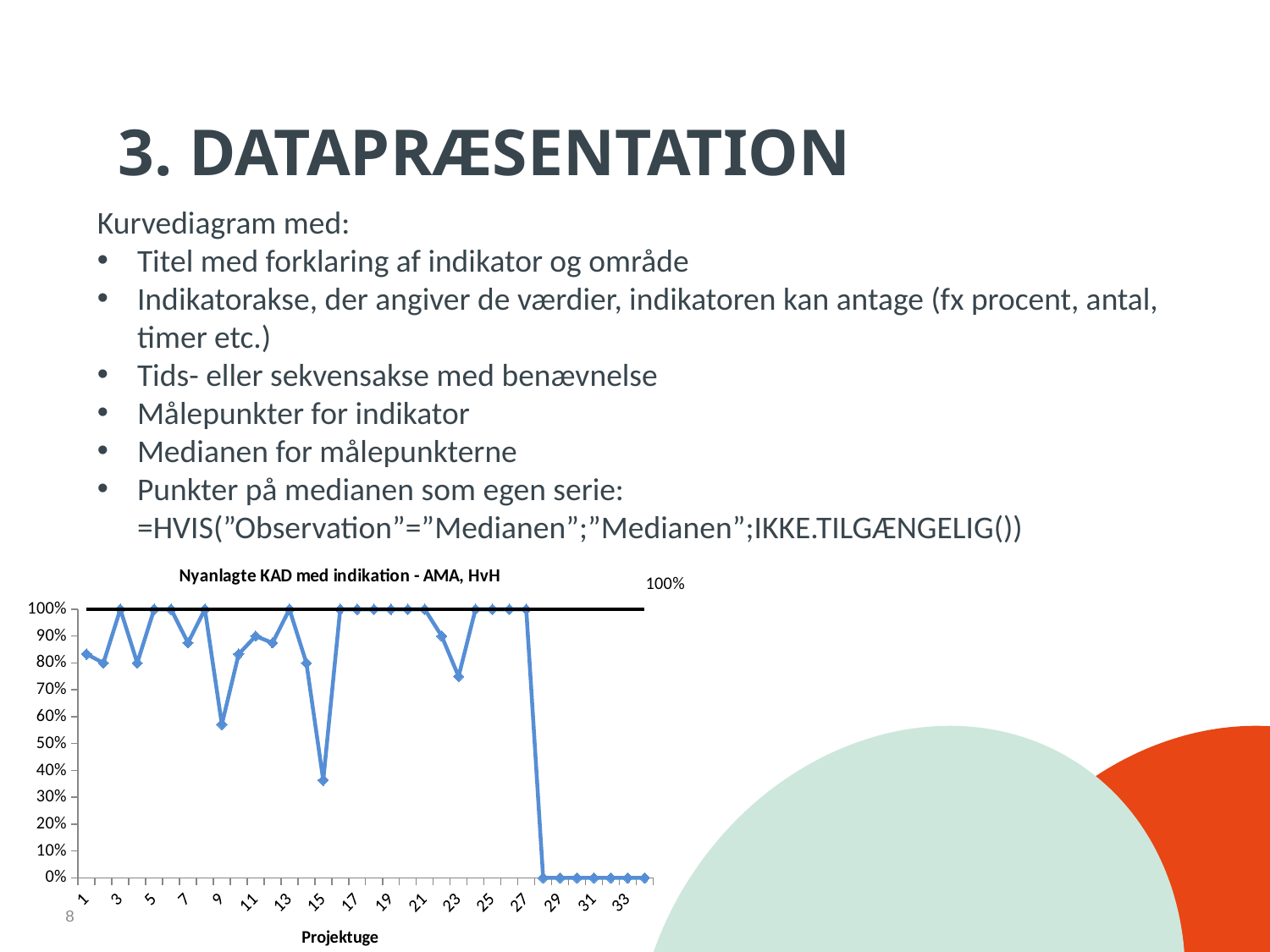
What kind of chart is shown on the slide? line chart What is the value for projektuge 30 in the chart? 0% What is the label of the x axis of the chart? Projektuge What value is printed next to the horizontal median line in the chart? 100% Is the value for projektuge 13 greater or less than 90%? greater Is the value for projektuge 15 greater or less than 50%? less What is the value for projektuge 3 in the chart? 100% Which is larger, the value for projektuge 9 or the value for projektuge 15? projektuge 9 Is the value for projektuge 9 greater or less than 70%? less Among projektuge 1 to 27, which week has the lowest value? 15 What is the title of the chart? Nyanlagte KAD med indikation - AMA, HvH Do the values rise or fall between projektuge 27 and projektuge 28? fall